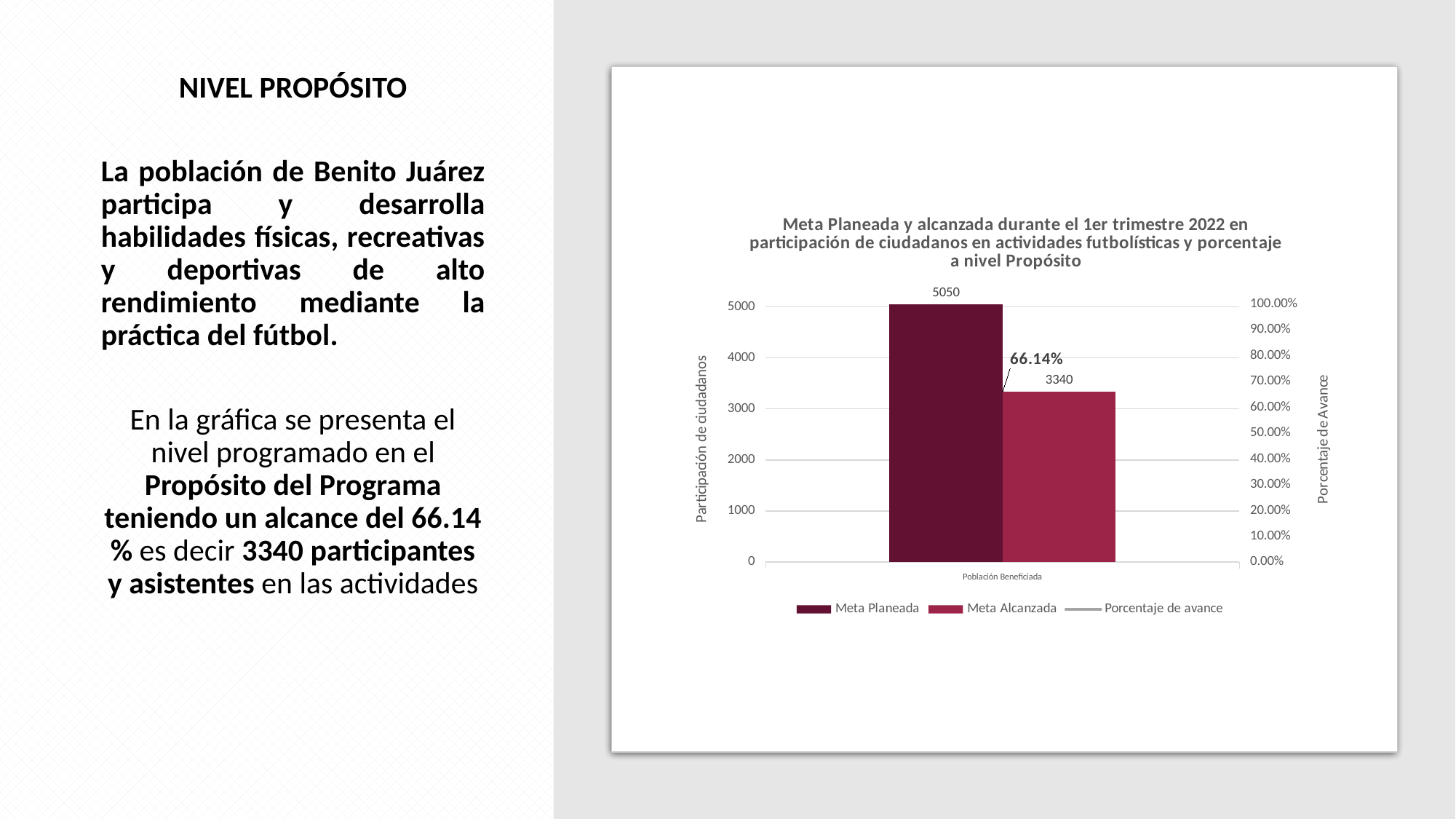
What is the difference between Meta Planeada and Meta Alcanzada? 1710 Which is larger, Meta Planeada or Meta Alcanzada? Meta Planeada How many categories are shown on the x axis? 1 What is the value of Meta Planeada for Población Beneficiada? 5050 What is the label of the right vertical axis? Porcentaje de Avance What kind of chart is shown on the slide? Bar chart Is the value for Meta Alcanzada greater or less than 4000? less What is the Porcentaje de avance shown on the chart? 66.14% Is the value for Meta Planeada greater or less than 4000? greater How many series does the legend list? 3 What is the value of Meta Alcanzada for Población Beneficiada? 3340 What is the label of the left vertical axis? Participación de ciudadanos